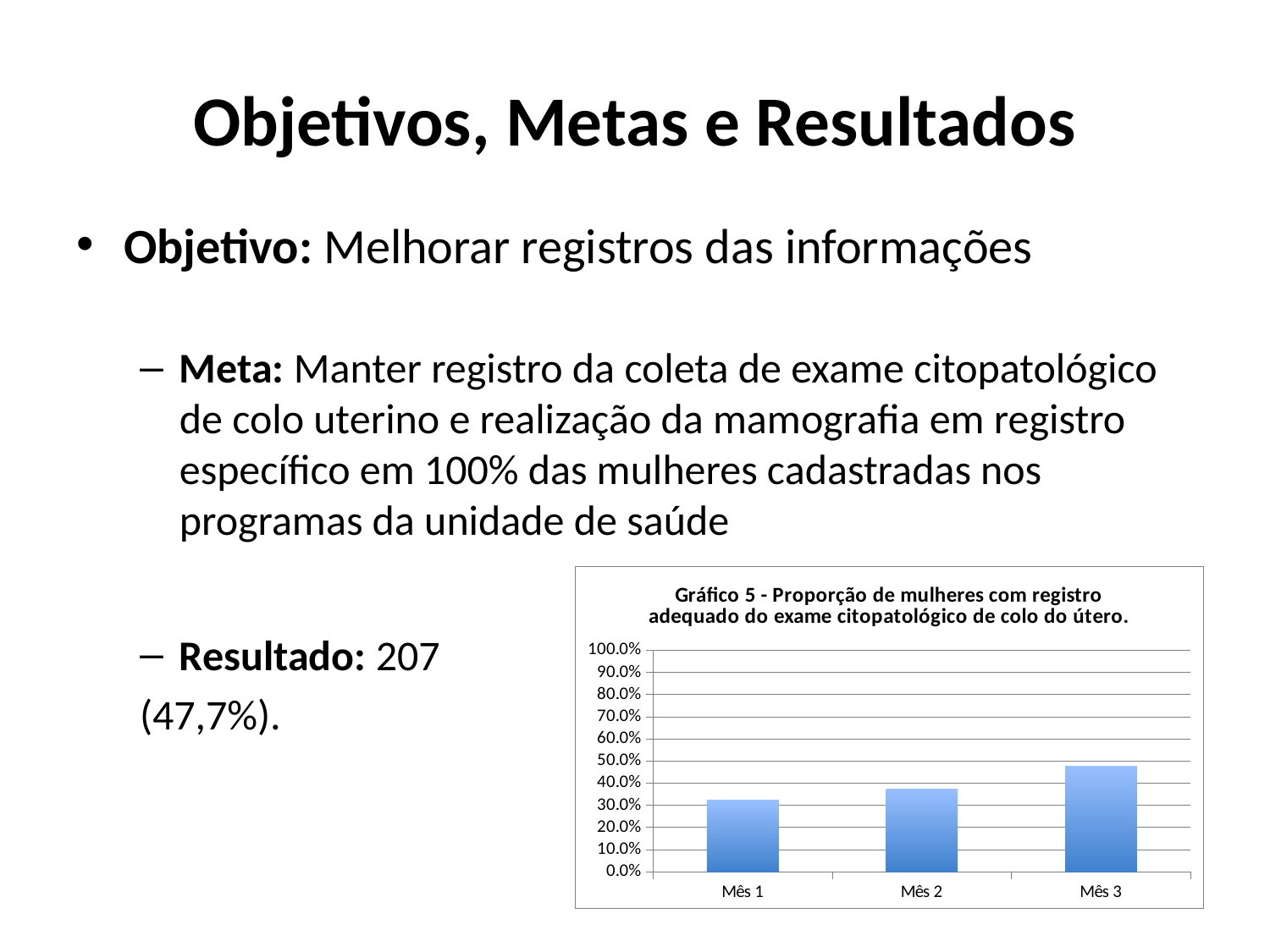
Is the value for Mês 1 greater or less than 40.0%? less Is the value for Mês 2 greater or less than 30.0%? greater Is the value for Mês 3 greater or less than 50.0%? less What kind of chart is shown on the slide? bar chart What is the highest value shown on the chart's vertical axis? 100.0% Which is larger, the value for Mês 2 or the value for Mês 3? Mês 3 What is the title of the chart? Gráfico 5 - Proporção de mulheres com registro adequado do exame citopatológico de colo do útero. How many categories (months) are plotted in the chart? 3 Do the values rise or fall from Mês 1 to Mês 3? rise Which month has the highest bar in the chart? Mês 3 Which month has the lowest bar in the chart? Mês 1